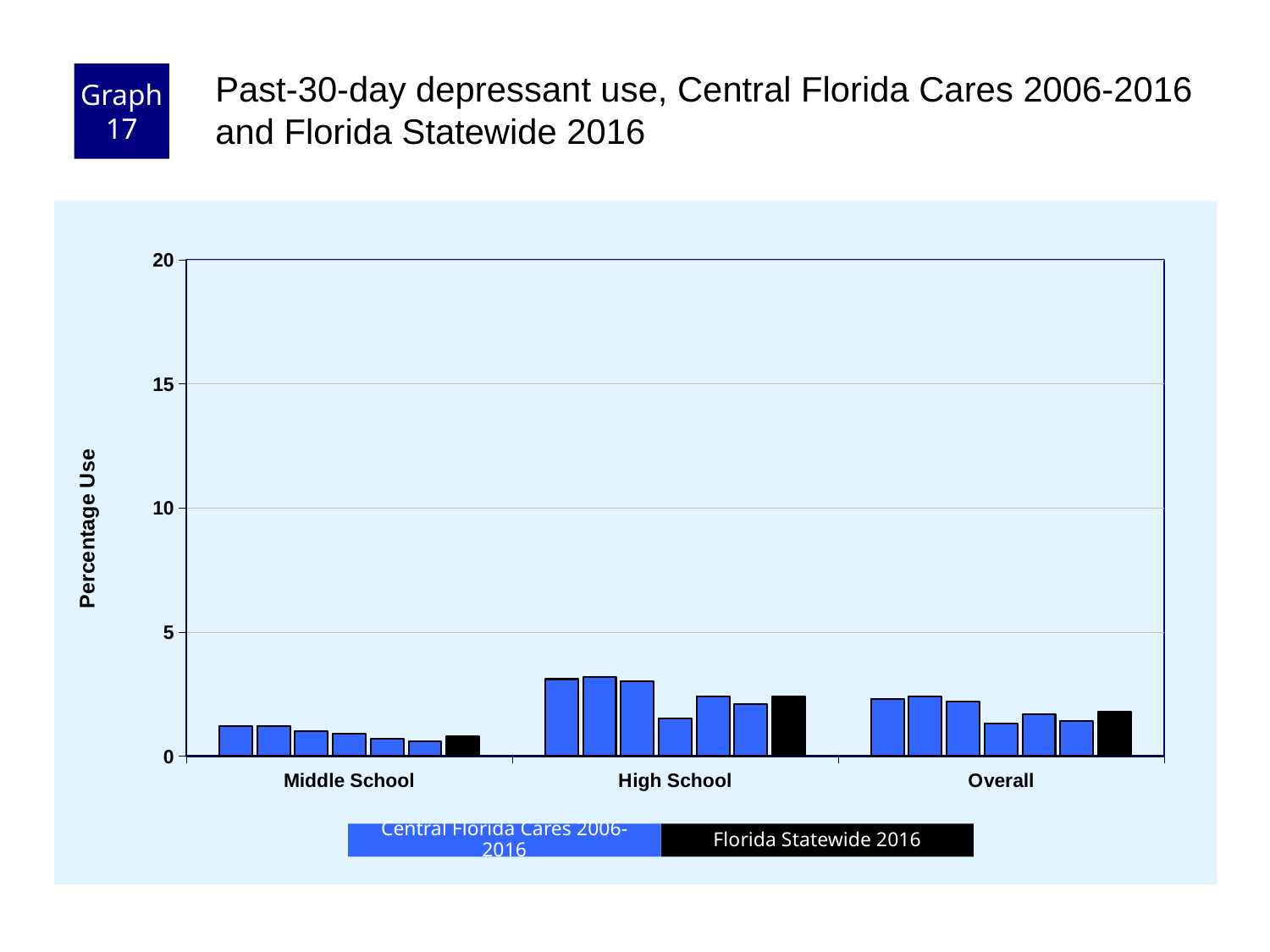
Is the Florida Statewide 2016 value for High School greater or less than 5? less Which colour represents Florida Statewide 2016 in the legend? black What is the label on the y axis? Percentage Use What kind of chart is shown on the slide? bar chart Which category has the highest Florida Statewide 2016 bar? High School Which is larger, the Florida Statewide 2016 value for High School or for Middle School? High School Which category has the lowest Florida Statewide 2016 bar? Middle School How many categories are shown on the x axis? 3 Are any of the bars on the chart greater than 10? no Within the Middle School category, do the Central Florida Cares 2006-2016 bars rise or fall from left to right? fall How many series does the legend list? 2 Is the Florida Statewide 2016 value for Middle School greater or less than 5? less